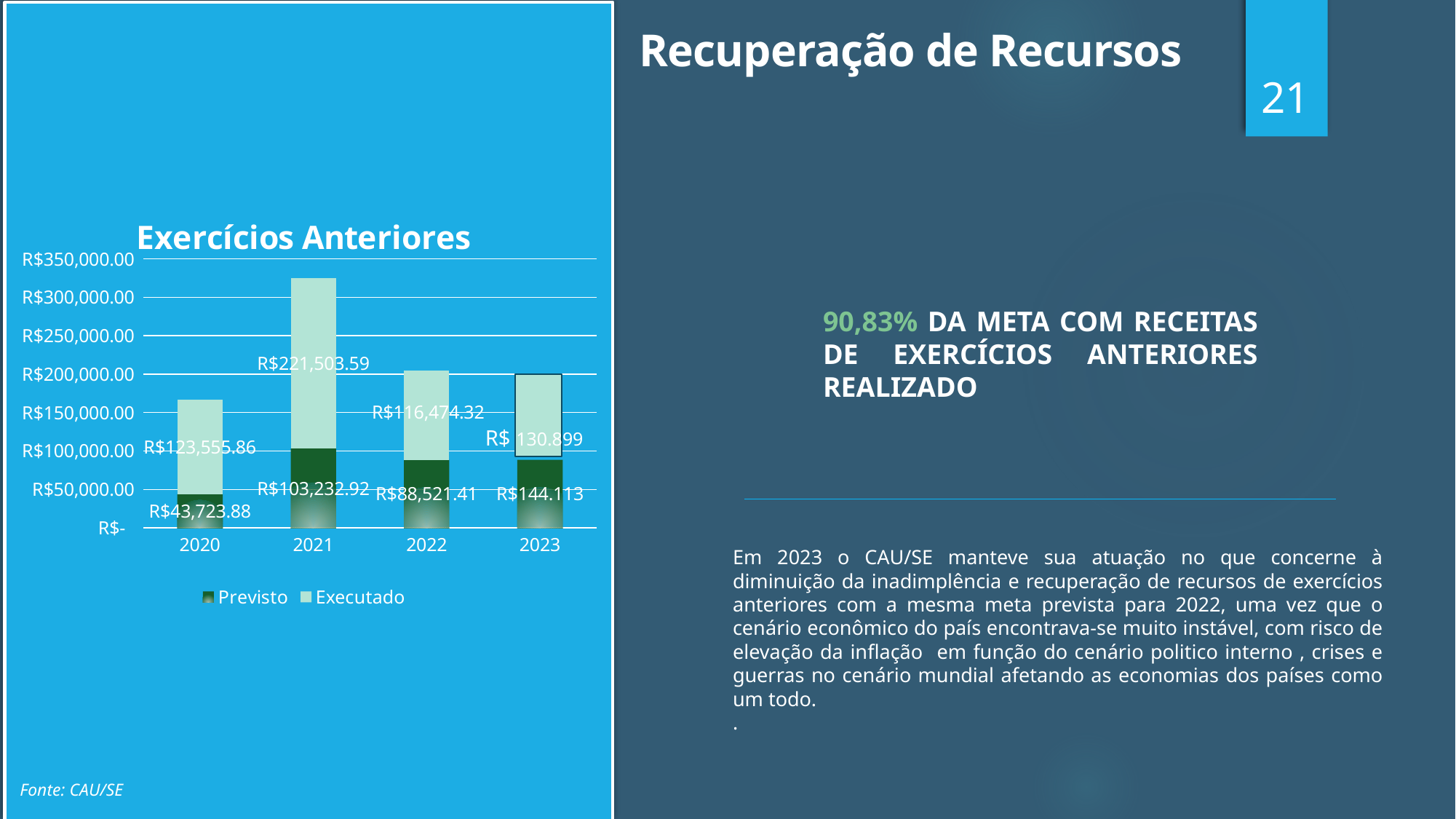
What kind of chart is shown on the slide? Stacked bar chart What is the Executado value for 2021? R$221,503.59 Which year has the highest Executado value? 2021 What is the difference between the Executado values for 2021 and 2020? R$97,947.73 Is the total height of the 2023 bar greater or less than R$150,000.00? greater Which year has the lowest Previsto value? 2020 How many years are shown on the x axis of the chart? 4 What is the title of the chart on the slide? Exercícios Anteriores How many series does the chart legend list? 2 What is the Previsto value for 2020? R$43,723.88 What is the Previsto value for 2022? R$88,521.41 What is the total of the stacked bar for 2022 (Previsto plus Executado)? R$204,995.73